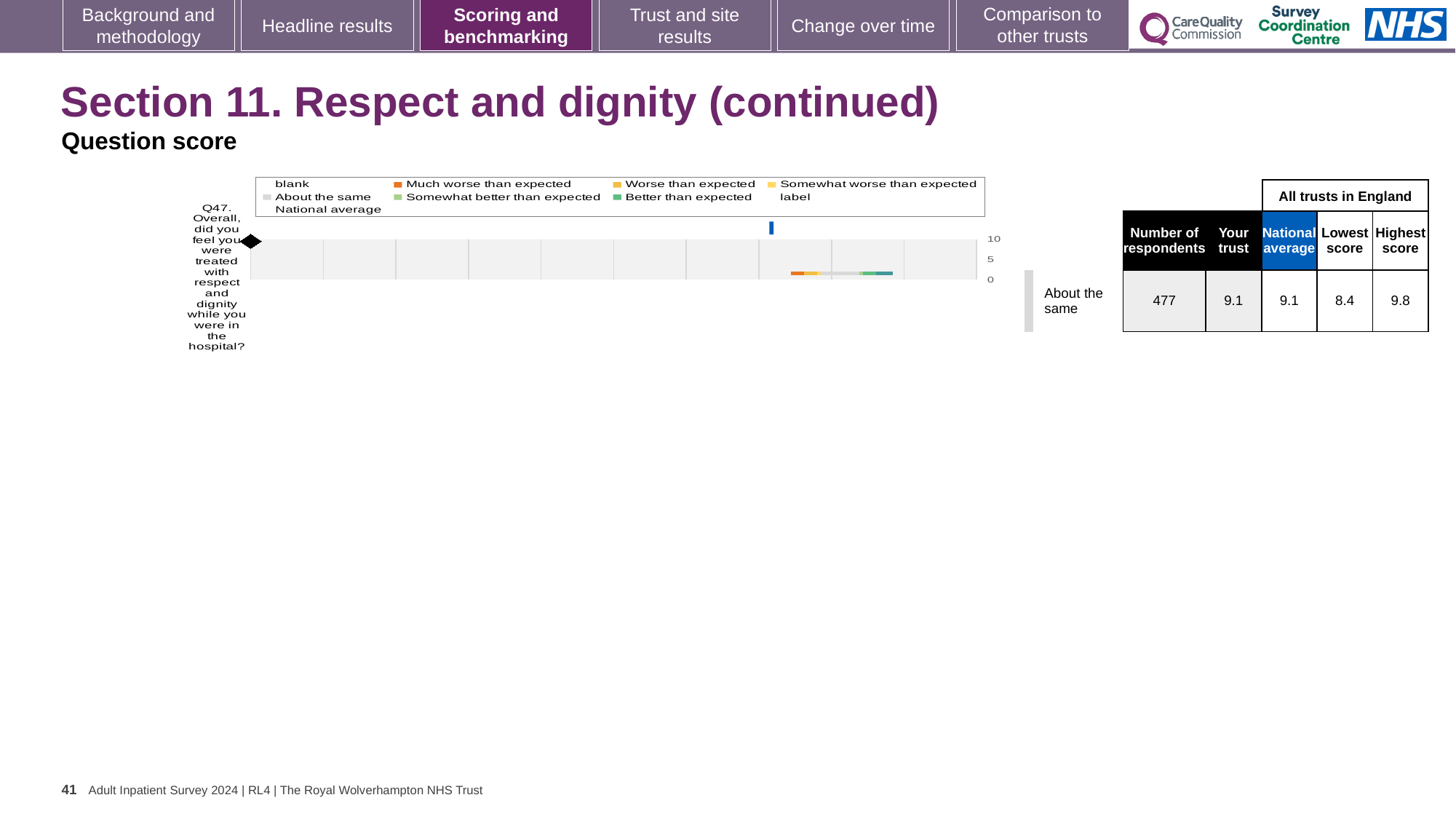
How many entries does the chart legend list? 9 What kind of chart is shown on the slide? bar chart What is the difference between the highest score and the lowest score for Q47 in the table? 1.4 What is the highest tick value shown on the chart's score axis? 10 Which question is plotted on the chart? Q47. Overall, did you feel you were treated with respect and dignity while you were in the hospital? In the table next to the chart, what is the national average score for Q47? 9.1 In the table next to the chart, what is the number of respondents for Q47? 477 What benchmark category is the trust's Q47 score given on the slide? About the same How many questions (categories) are plotted on the chart? 1 In the table next to the chart, what is the lowest score among all trusts in England for Q47? 8.4 In the table next to the chart, what is the highest score among all trusts in England for Q47? 9.8 In the table next to the chart, what is the 'Your trust' score for Q47? 9.1